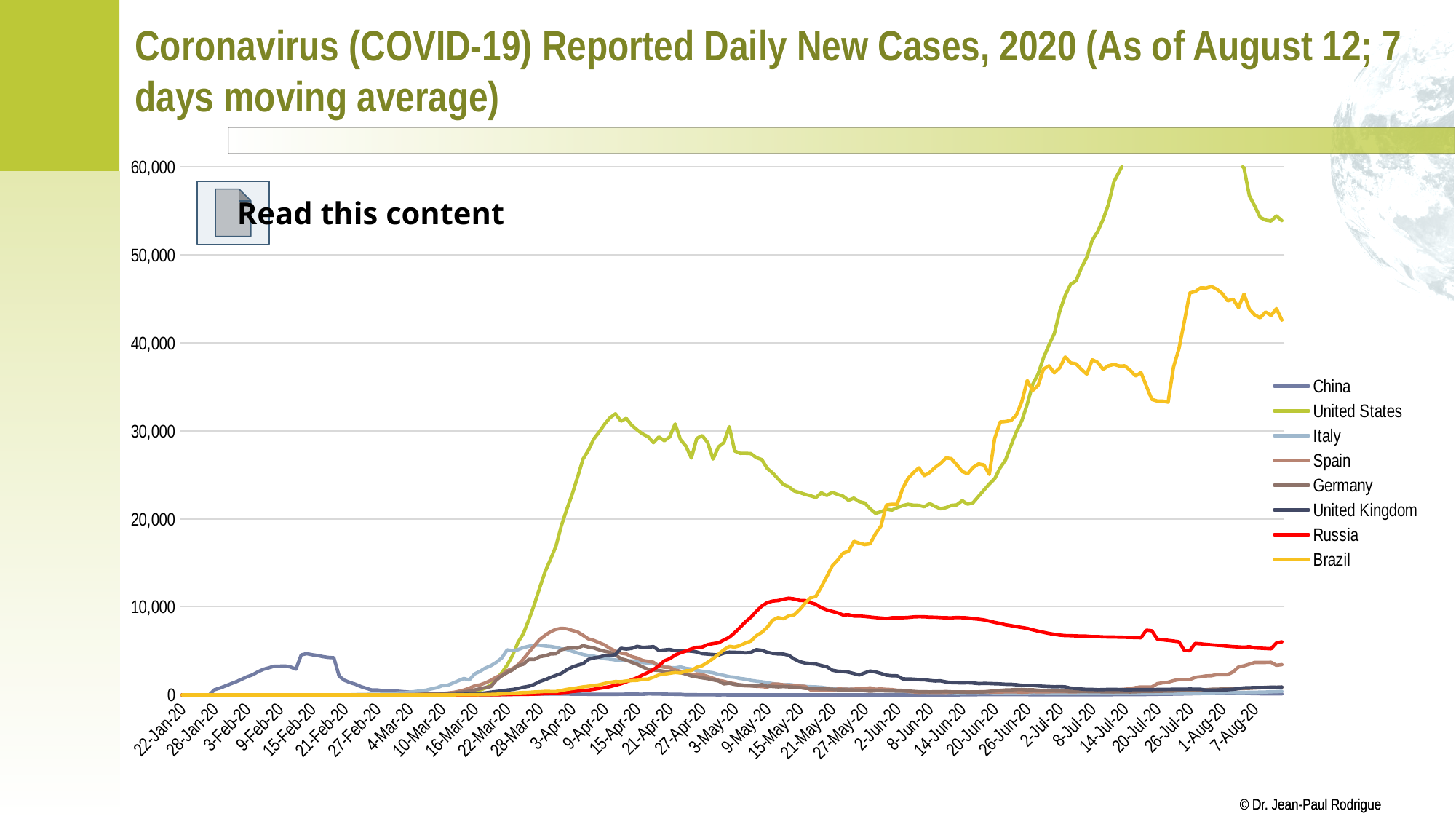
Does the Russia series rise or fall between 15-May-20 and 7-Aug-20? fall Does the Brazil series rise or fall between 27-Apr-20 and 2-Jul-20? rise How many series does the legend list? 8 Is the peak value for Germany greater or less than 10,000? less What kind of chart is shown on the slide? line chart What colour is the line for Russia? red Which series reaches the highest value on the chart? United States Is the value for Brazil on 7-Aug-20 greater or less than 40,000? greater On 7-Aug-20, which is larger: the value for Brazil or the value for Russia? Brazil Is the value for the United States on 14-Jul-20 greater or less than 50,000? greater On 7-Aug-20, which is larger: the value for the United States or the value for Brazil? United States